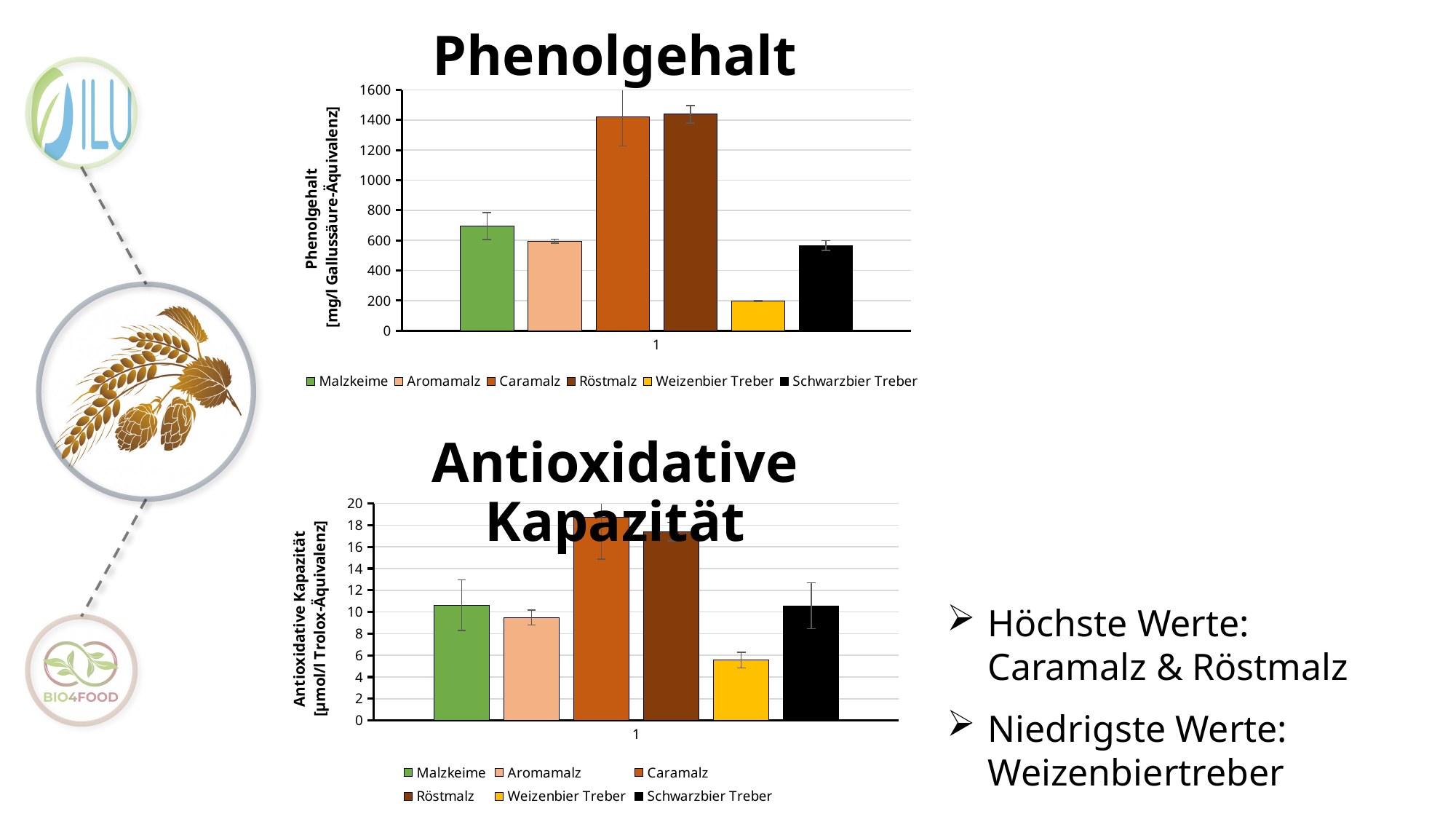
In the Phenolgehalt chart, which is larger, Malzkeime or Aromamalz? Malzkeime In the Phenolgehalt chart, is the value for Malzkeime greater or less than 600? greater In the Phenolgehalt chart, is the value for Weizenbier Treber greater or less than 400? less What is the y-axis label of the Antioxidative Kapazität chart? Antioxidative Kapazität [µmol/l Trolox-Äquivalenz] In the Antioxidative Kapazität chart, is the value for Weizenbier Treber greater or less than 8? less How many series does the legend of the Phenolgehalt chart list? 6 What kind of chart is the Phenolgehalt chart? bar chart In the Antioxidative Kapazität chart, which is larger, Caramalz or Schwarzbier Treber? Caramalz In the Antioxidative Kapazität chart, which series has the lowest value? Weizenbier Treber In the Phenolgehalt chart, which series has the lowest value? Weizenbier Treber